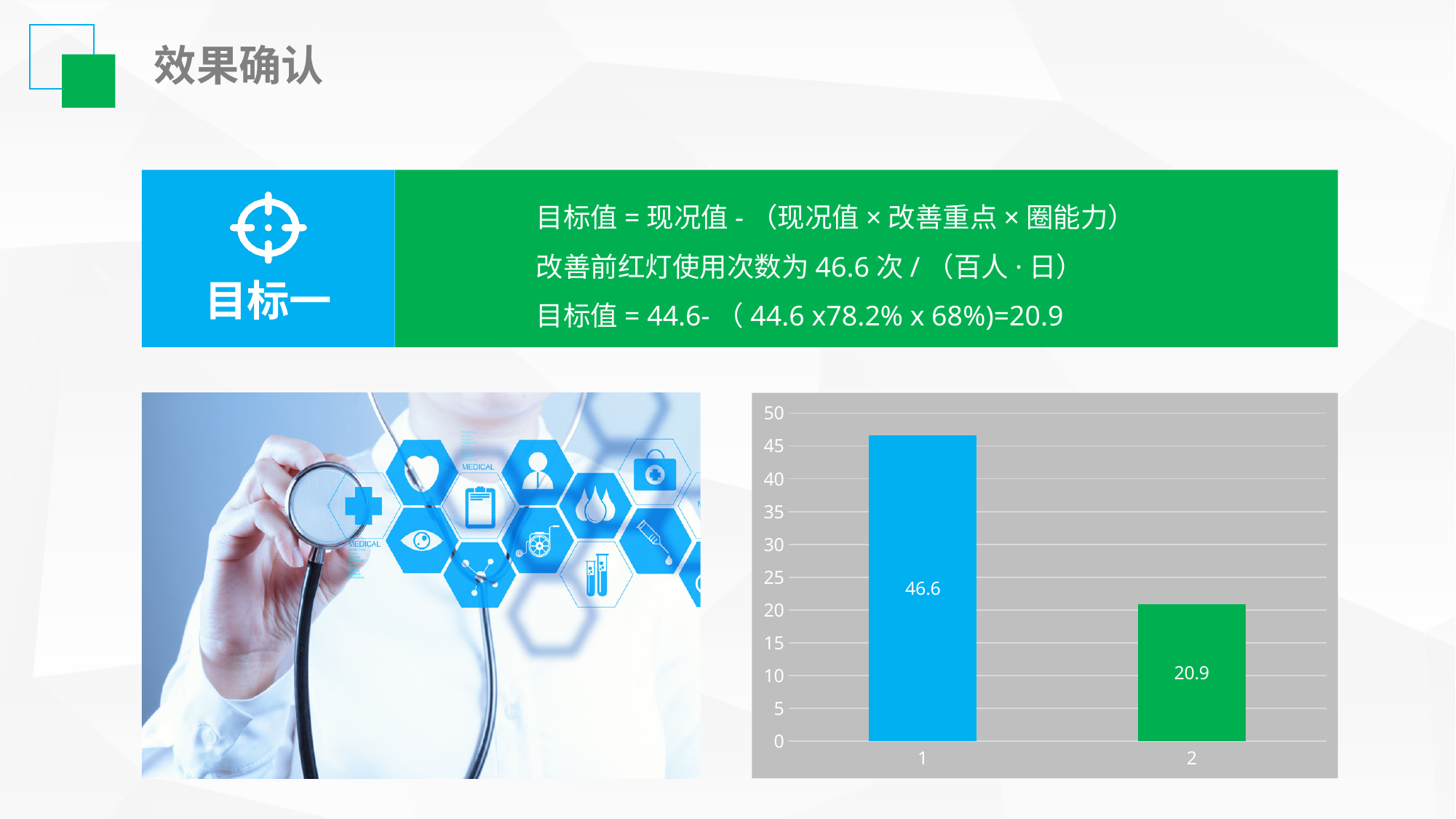
What kind of chart is shown on the slide? bar chart What is the difference between the values for category 1 and category 2? 25.7 Which category has the highest value? 1 Which category has the lowest value? 2 Is the value for category 2 greater or less than 25? less Is the value for category 1 greater or less than 40? greater What is the value of the bar for category 2? 20.9 What is the maximum value shown on the vertical axis? 50 What is the value of the bar for category 1? 46.6 Do the values rise or fall from category 1 to category 2? fall Which is larger, the value for category 1 or category 2? 1 How many bars are shown in the chart? 2